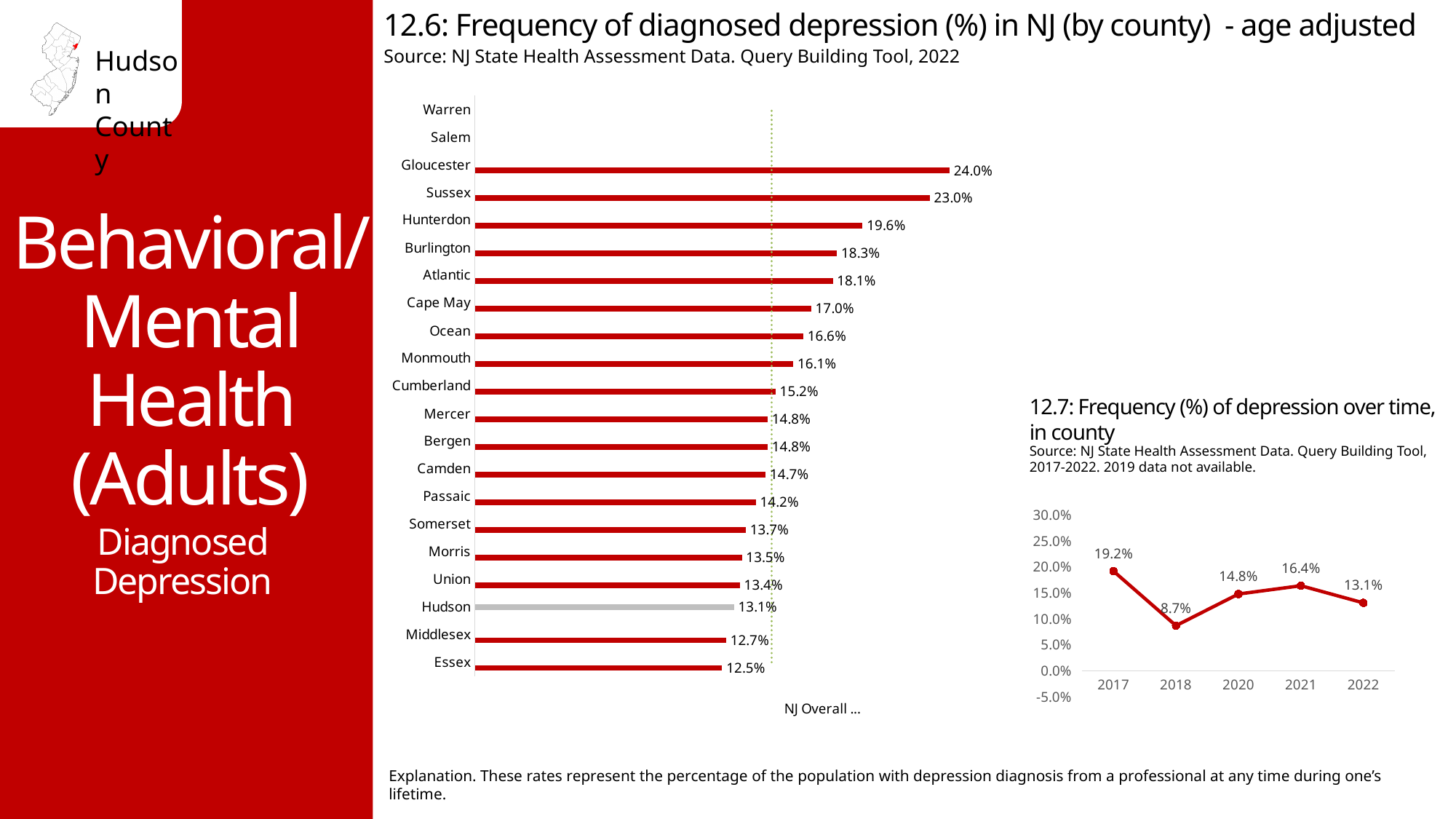
In chart 12.7, what is the frequency of depression in 2018? 8.7% In chart 12.7, what is the difference between the 2021 and 2022 values? 3.3% In chart 12.6, which has a higher value, Burlington or Cape May? Burlington In chart 12.7, is the value for 2020 greater or less than 10.0%? greater In chart 12.7, how many years are plotted? 5 In chart 12.6, what is the frequency of diagnosed depression for Hudson County? 13.1% In chart 12.6, which county with a plotted bar has the lowest frequency of diagnosed depression? Essex What type of chart is chart 12.6? Bar chart In chart 12.6, what is the difference between the values for Sussex and Hudson? 9.9% In chart 12.6, what is the value shown for Gloucester? 24.0% In chart 12.6, which county has the highest frequency of diagnosed depression? Gloucester In chart 12.7, which year has the highest frequency of depression? 2017